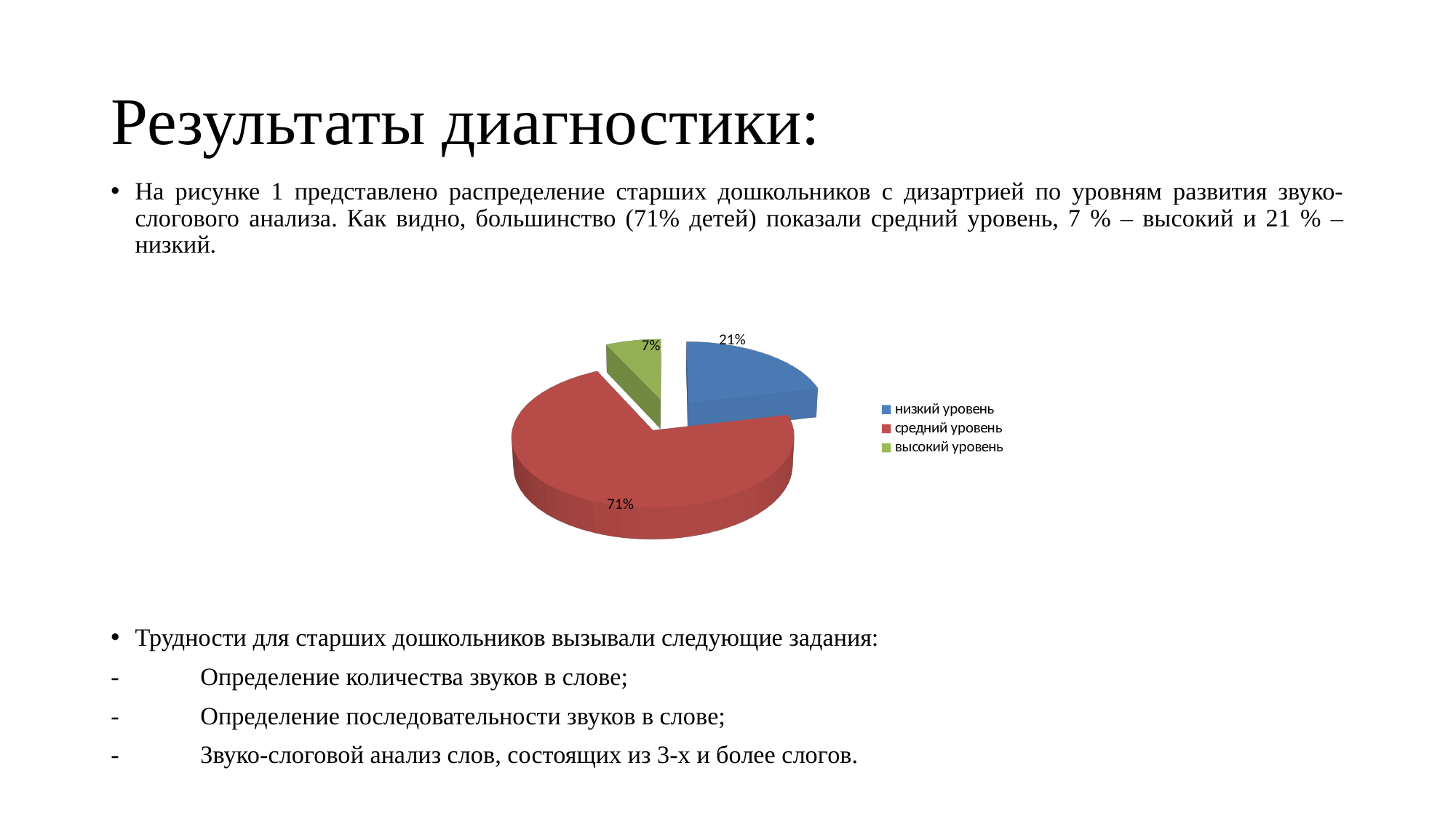
Which category has the largest slice of the pie? средний уровень What is the difference between the shares of "средний уровень" and "низкий уровень"? 50% Which category has the smallest slice of the pie? высокий уровень How many entries does the legend list? 3 What share of the pie does "средний уровень" have? 71% What kind of chart is shown on the slide? pie chart What colour is the slice for "средний уровень"? red What share of the pie does "низкий уровень" have? 21% What colour is the slice for "низкий уровень"? blue How many slices does the pie chart have? 3 Which is larger, the share of "низкий уровень" or "высокий уровень"? низкий уровень What share of the pie does "высокий уровень" have? 7%